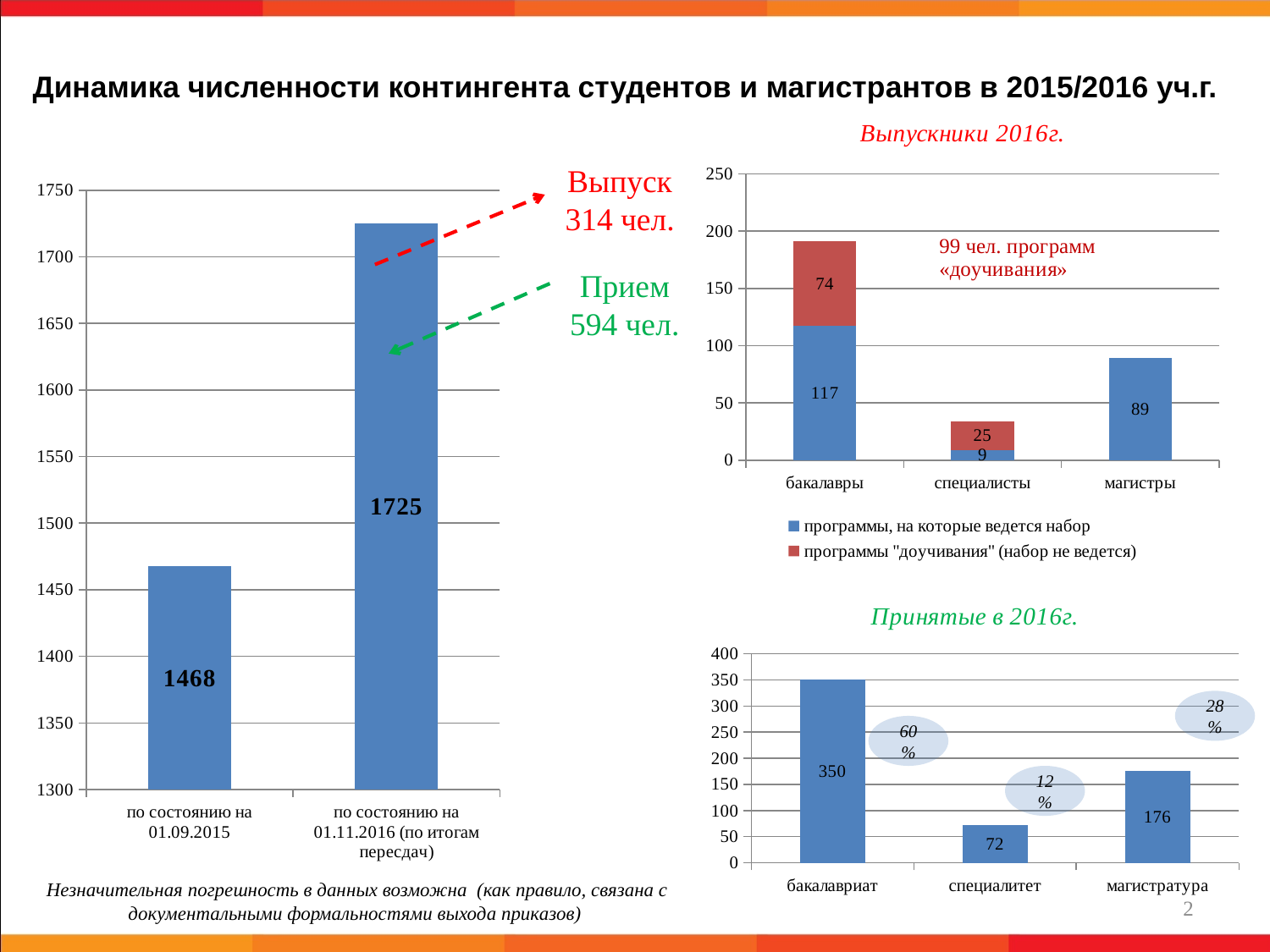
In the left chart, what is the value for "по состоянию на 01.09.2015"? 1468 In the chart "Выпускники 2016г.", what is the value of "программы "доучивания" (набор не ведется)" for специалисты? 25 In the chart "Выпускники 2016г.", what is the value of "программы, на которые ведется набор" for бакалавры? 117 In the chart "Принятые в 2016г.", which category has the highest value? бакалавриат In the chart "Выпускники 2016г.", what is the total of the stacked bar for бакалавры? 191 In the left chart, what is the value for "по состоянию на 01.11.2016 (по итогам пересдач)"? 1725 In the chart "Выпускники 2016г.", how many series does the legend list? 2 In the left chart, do the values rise or fall from 01.09.2015 to 01.11.2016? rise What kind of chart is "Принятые в 2016г."? bar chart In the chart "Выпускники 2016г.", which category has the lowest total? специалисты In the chart "Принятые в 2016г.", what is the value for магистратура? 176 In the left chart, what is the difference between the 01.11.2016 value and the 01.09.2015 value? 257